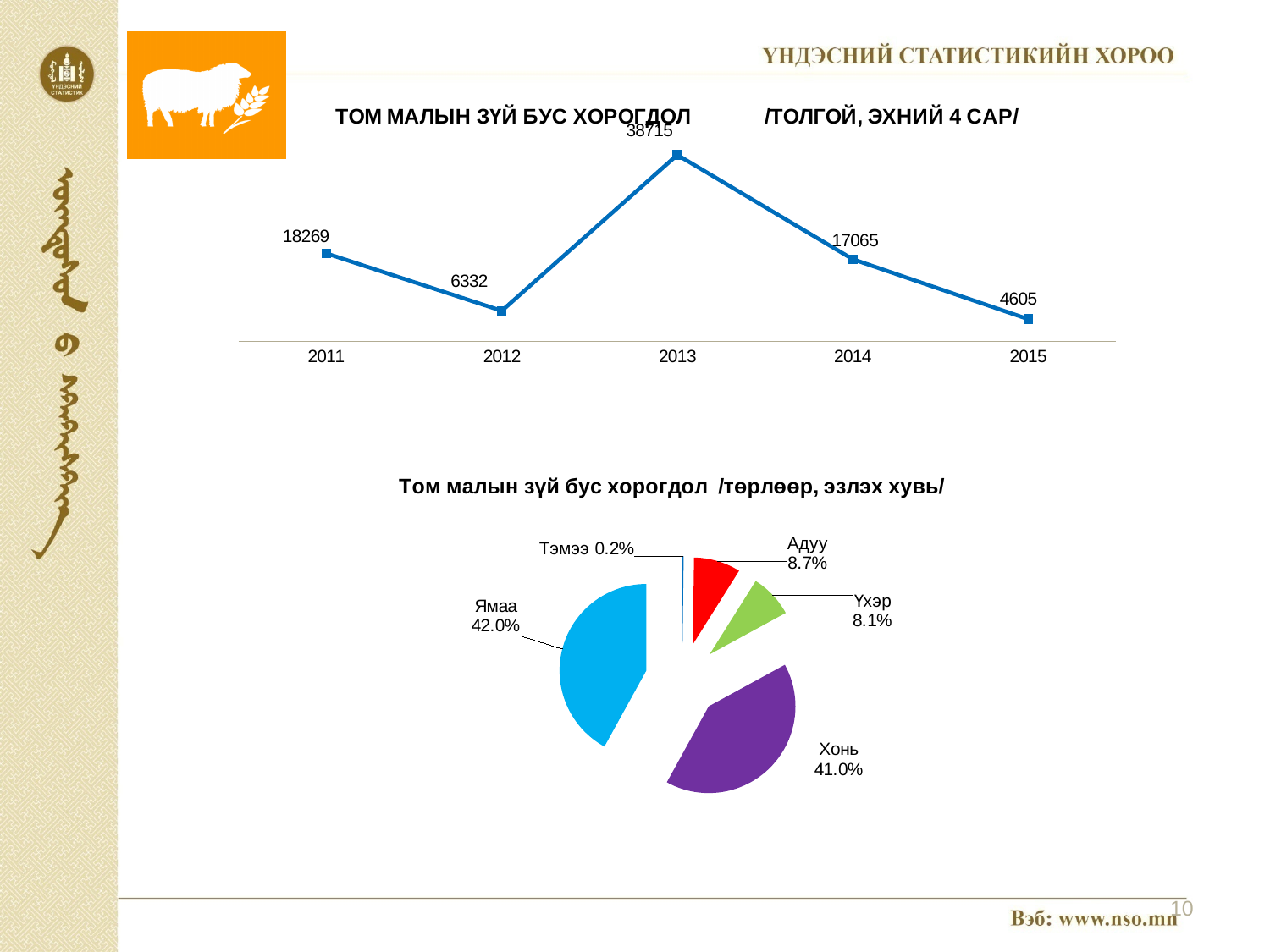
In the top line chart, what is the value for 2013? 38715 How many years are plotted in the top line chart? 5 In the top line chart, what is the value for 2015? 4605 In the top line chart, which year has the lowest value? 2015 In the top line chart, which is larger, the value for 2011 or the value for 2014? 2011 In the top line chart, what is the difference between the values for 2011 and 2012? 11937 What kind of chart is the top chart on the slide? line chart In the top line chart, do the values rise or fall from 2013 to 2015? fall How many slices does the bottom pie chart have? 5 In the top line chart, which year has the highest value? 2013 In the bottom pie chart, what share does Ямаа have? 42.0% In the bottom pie chart, which category has the smallest share? Тэмээ